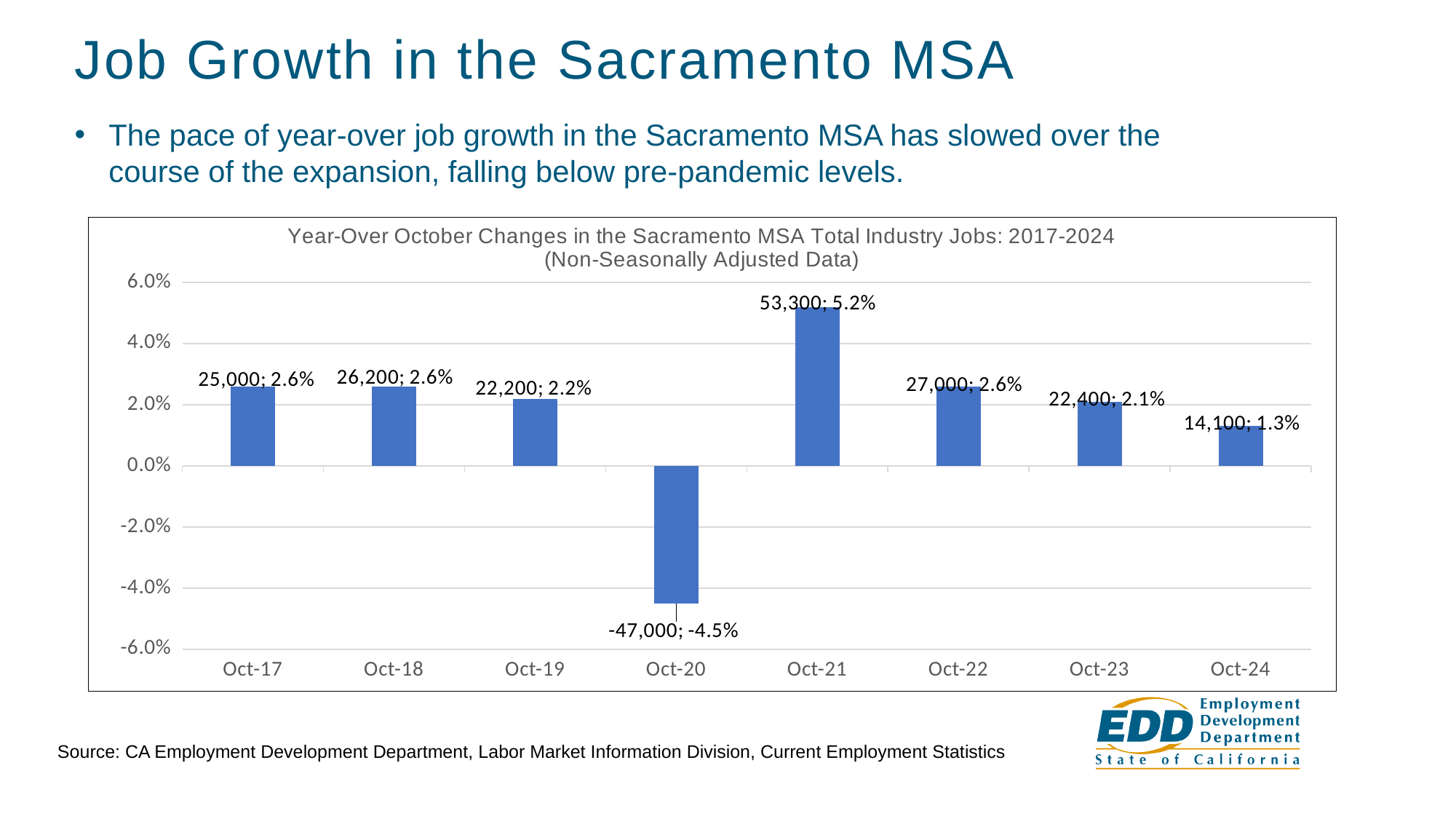
From Oct-21 to Oct-24, do the percentage changes rise or fall? Fall Which October has the lowest year-over percentage change? Oct-20 What is the job change in number of jobs shown for Oct-20? -47,000 How many Octobers (bars) are shown in the chart? 8 What is the percentage change shown for Oct-24? 1.3% What is the percentage change in total industry jobs shown for Oct-21? 5.2% Which has a larger percentage change, Oct-19 or Oct-23? Oct-19 What kind of chart is shown on the slide? Bar chart What is the difference in number of jobs between Oct-21 (53,300) and Oct-24 (14,100)? 39,200 Which October has the highest year-over percentage change? Oct-21 What is the title of the chart? Year-Over October Changes in the Sacramento MSA Total Industry Jobs: 2017-2024 (Non-Seasonally Adjusted Data) Is the value for Oct-21 greater or less than 4.0%? greater